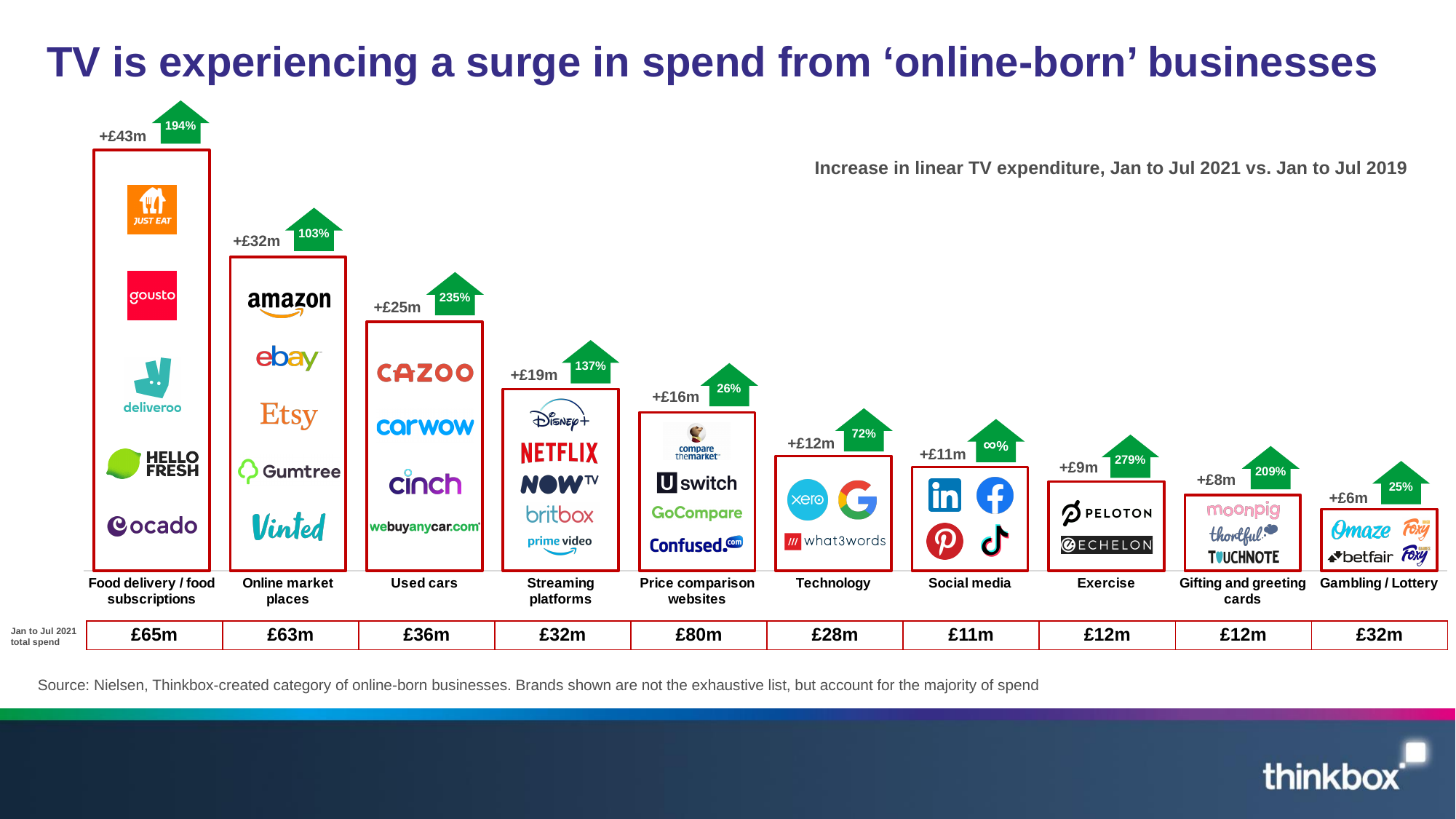
What percentage increase is shown for the Used cars category? 235% What kind of chart is shown on the slide? Bar chart What is the Jan to Jul 2021 total spend for the Exercise category? £12m Which category has the largest increase in linear TV expenditure in £m? Food delivery / food subscriptions What is the increase in linear TV expenditure for the Food delivery / food subscriptions category? +£43m What is the difference in £m increase between Online market places and Used cars? £7m What is the Jan to Jul 2021 total spend for Price comparison websites? £80m What percentage increase is shown for the Social media category? ∞% Which has a larger £m increase, Streaming platforms or Technology? Streaming platforms How many categories are shown in the chart? 10 Do the £m increase values rise or fall moving from left to right across the categories? Fall Which category has the smallest increase in linear TV expenditure in £m? Gambling / Lottery